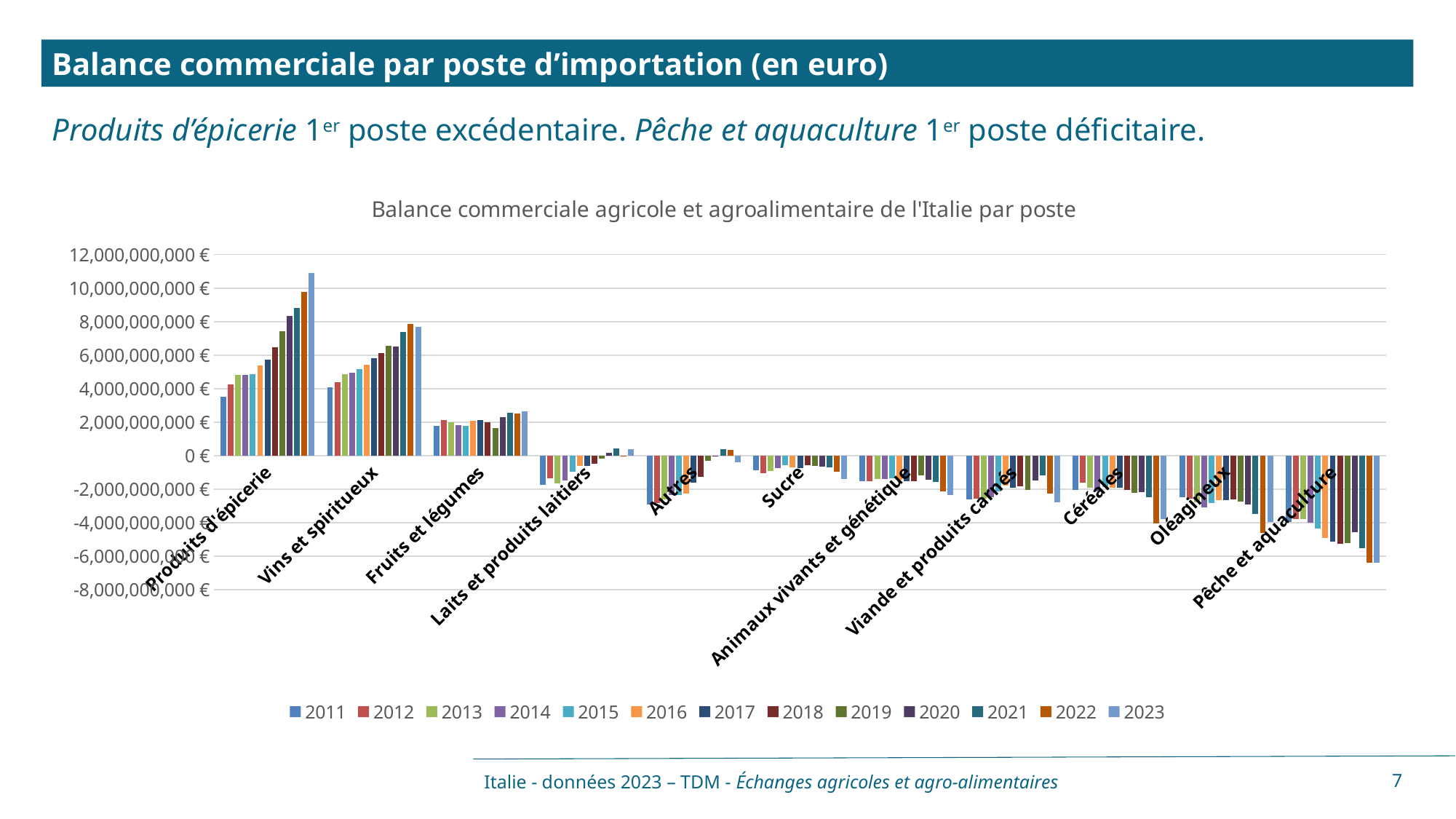
Which year is the first entry in the legend? 2011 Is the 2023 value for Vins et spiritueux greater or less than 8,000,000,000 €? less Is the 2023 value for Pêche et aquaculture greater or less than -6,000,000,000 €? less Is the 2023 value for Produits d'épicerie greater or less than 10,000,000,000 €? greater How many series does the legend list? 13 Which is larger in 2023: Produits d'épicerie or Vins et spiritueux? Produits d'épicerie How many categories (postes) are shown on the x axis? 11 What is the title of the chart? Balance commerciale agricole et agroalimentaire de l'Italie par poste Do the values for Produits d'épicerie generally rise or fall from 2011 to 2023? rise Which category has the highest bar in the chart? Produits d'épicerie What kind of chart is shown on the slide? Bar chart Which category has the lowest (most negative) bar in the chart? Pêche et aquaculture